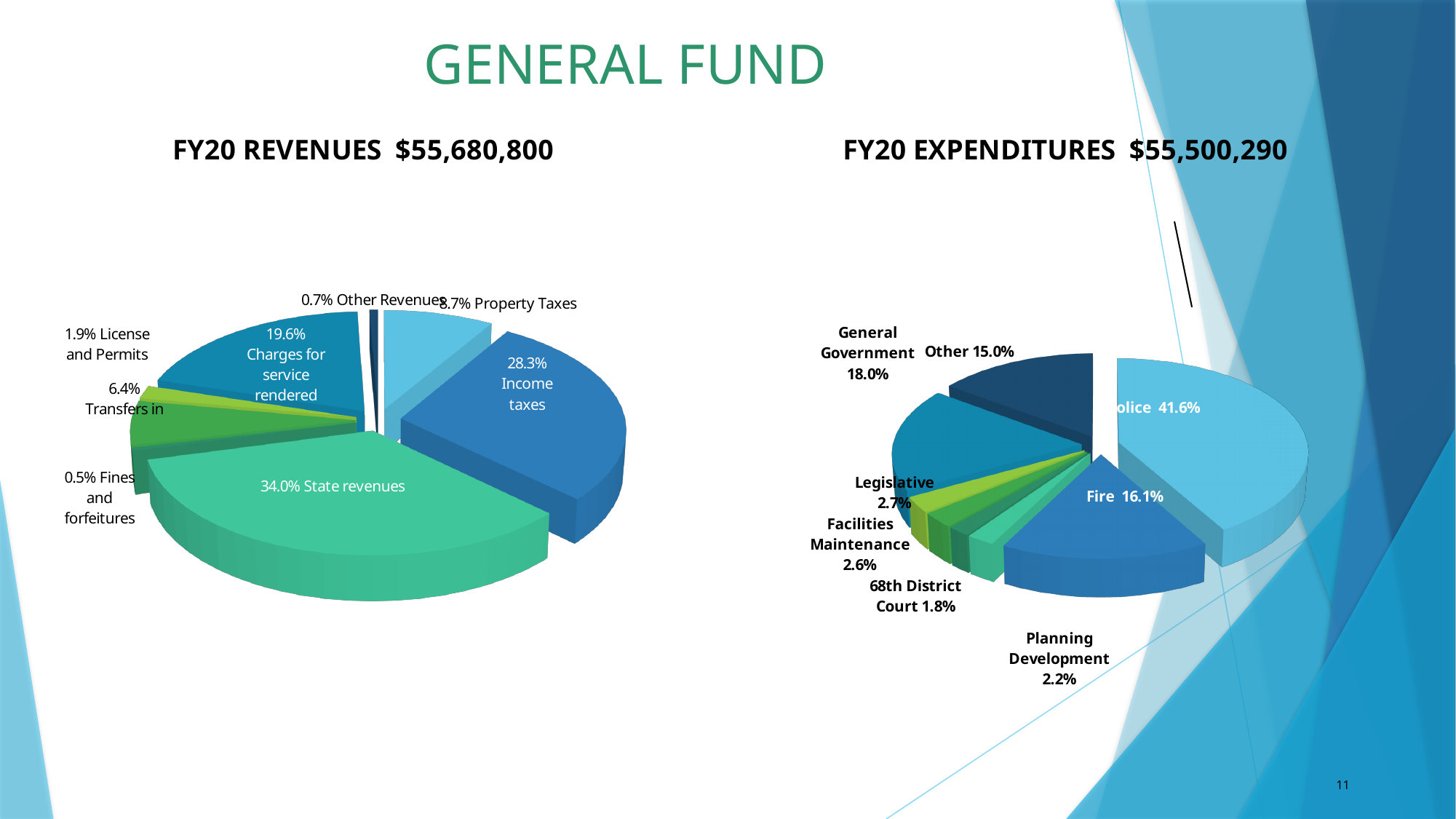
On the FY20 Revenues chart, which category has the smallest share? Fines and forfeitures On the FY20 Expenditures chart, which category has the largest share? Police On the FY20 Expenditures chart, what percentage is General Government? 18.0% On the FY20 Revenues chart, what is the difference in percentage points between Income taxes and Property Taxes? 19.6 On the FY20 Expenditures chart, which is larger, Legislative or Facilities Maintenance? Legislative On the FY20 Revenues chart, what percentage is Charges for service rendered? 19.6% On the FY20 Expenditures chart, what share of expenditures goes to Fire? 16.1% On the FY20 Revenues chart, which category has the largest share? State revenues What type of chart is used for the FY20 Expenditures? Pie chart On the FY20 Revenues chart, how many slices does the pie have? 8 On the FY20 Revenues chart, what share of revenues comes from State revenues? 34.0% On the FY20 Expenditures chart, what is the difference in percentage points between Police and Fire? 25.5